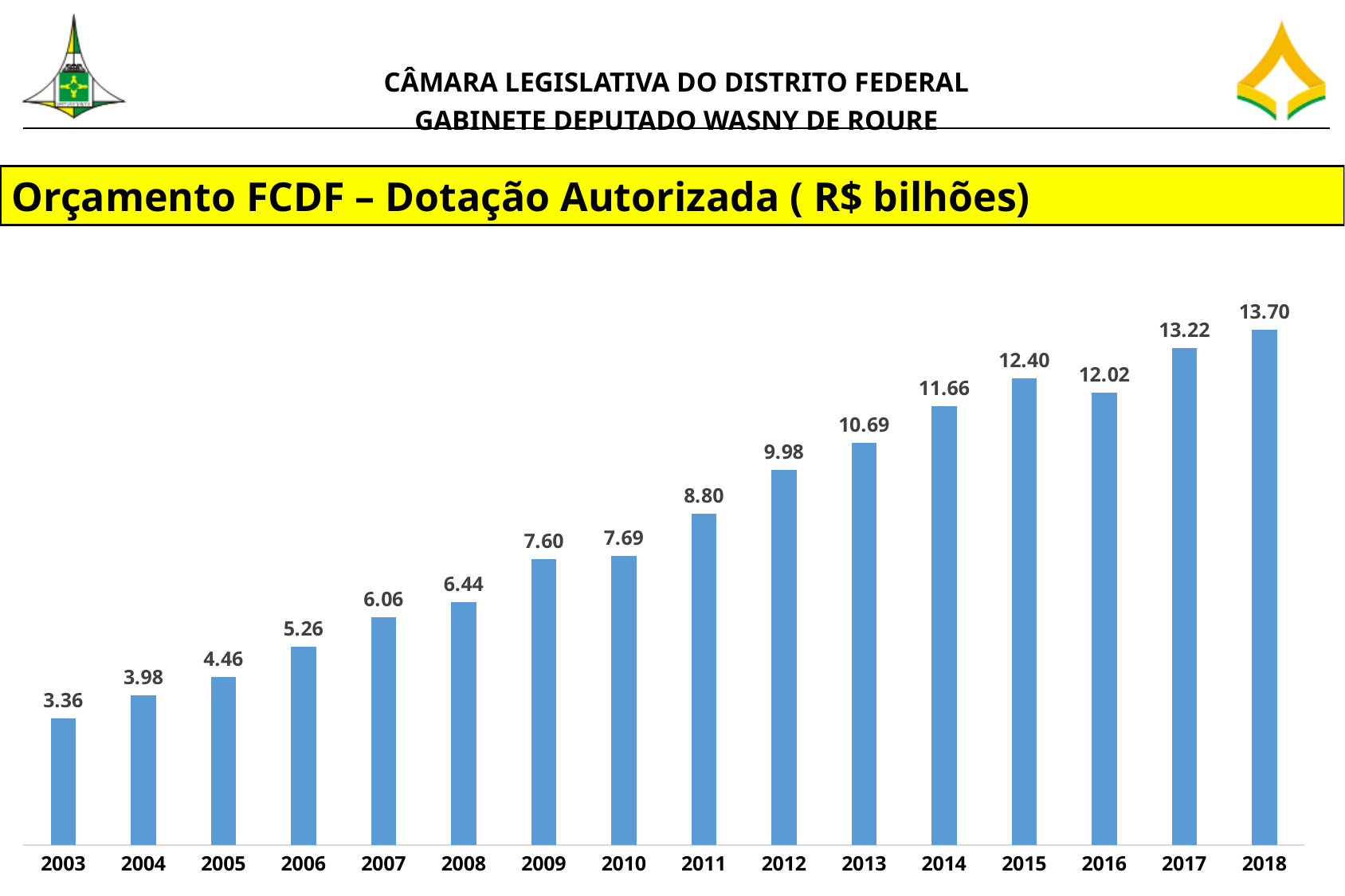
Which year has the lowest value? 2003 What is the title of the chart? Orçamento FCDF – Dotação Autorizada ( R$ bilhões) What is the difference between the values for 2015 and 2016? 0.38 What is the value for 2003? 3.36 What kind of chart is shown on the slide? bar chart Which is larger, the value for 2015 or the value for 2016? 2015 How many years are shown on the x axis? 16 Which is larger, the value for 2009 or the value for 2010? 2010 What is the value for 2012? 9.98 What is the value for 2016? 12.02 Which year has the highest value? 2018 What is the difference between the values for 2018 and 2017? 0.48